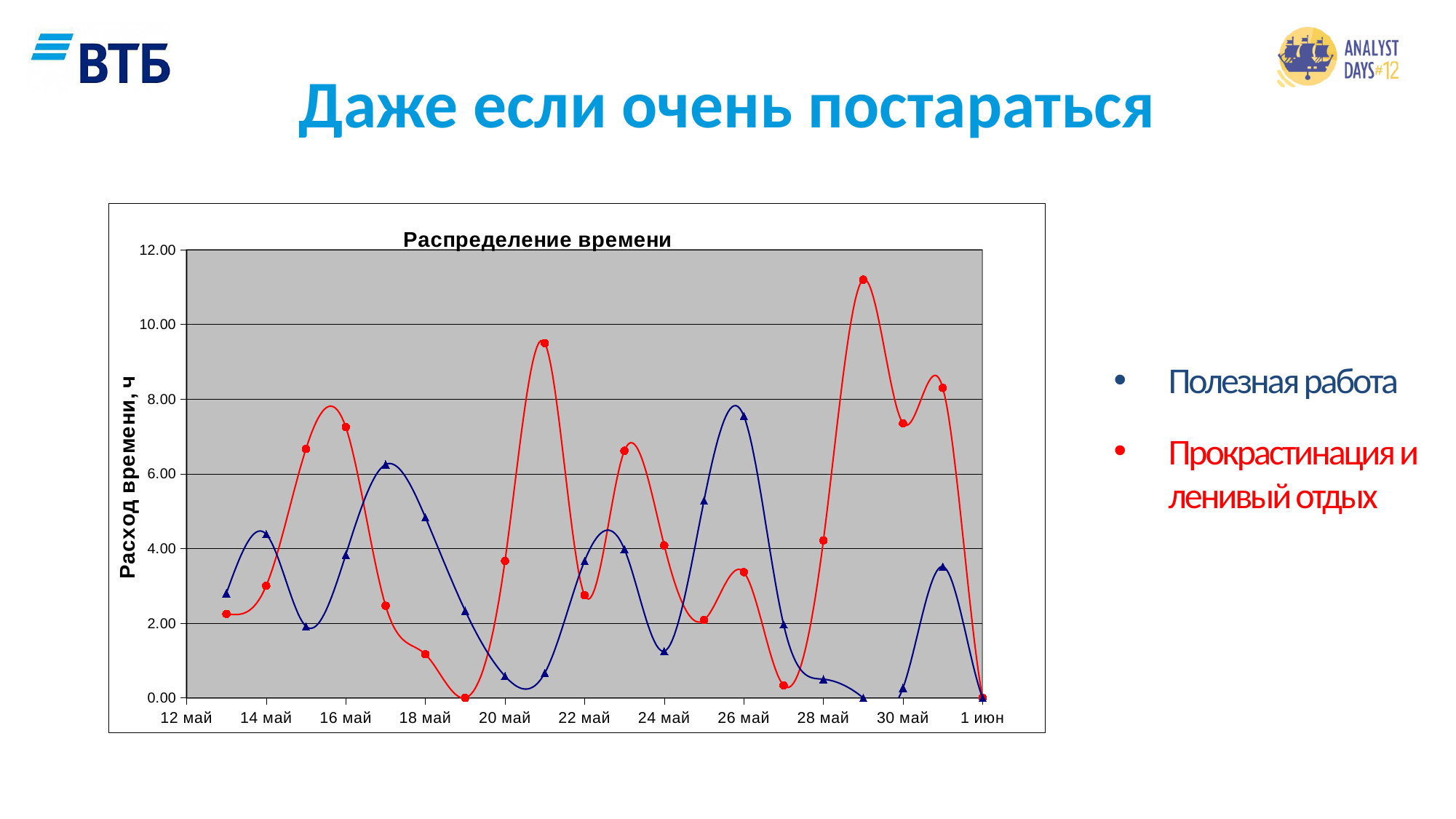
What is the label of the vertical axis? Расход времени, ч On 26 май, which series has the larger value, Полезная работа or Прокрастинация и ленивый отдых? Полезная работа What is the title of the chart? Распределение времени Is the value for Прокрастинация и ленивый отдых on 21 май greater or less than 8.00? greater On 16 май, which series has the larger value, Полезная работа or Прокрастинация и ленивый отдых? Прокрастинация и ленивый отдых What kind of chart is shown on the slide? line chart Is the value for Прокрастинация и ленивый отдых on 29 май greater or less than 10.00? greater On which date does Прокрастинация и ленивый отдых reach its highest value? 29 май Is the value for Полезная работа on 20 май greater or less than 2.00? less How many series does the legend list? 2